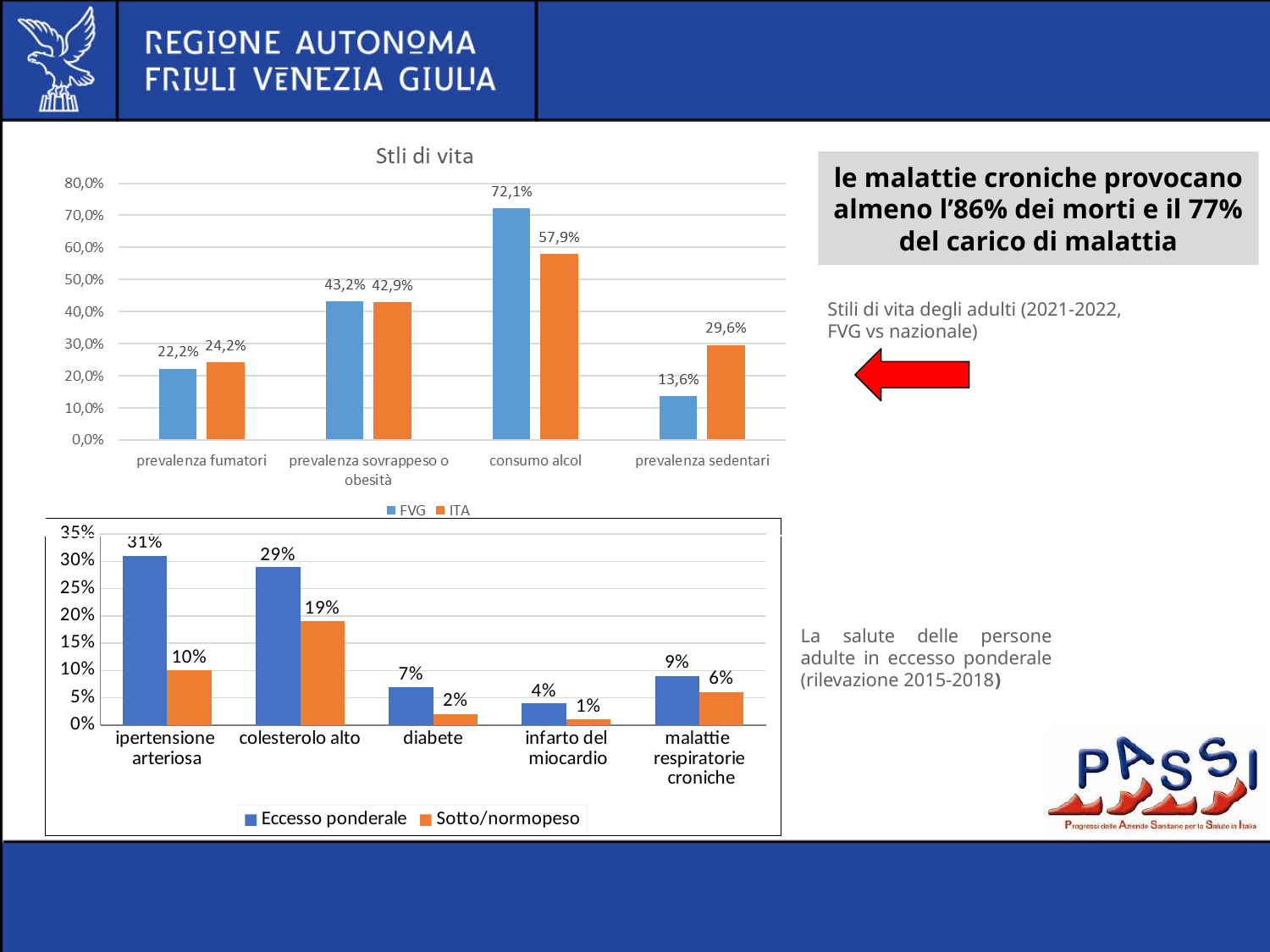
In the bottom chart, what is the difference between the Eccesso ponderale and Sotto/normopeso values for ipertensione arteriosa? 21 percentage points In the bottom chart, what is the Sotto/normopeso value for infarto del miocardio? 1% In the 'Stli di vita' chart, which category has the lowest FVG value? prevalenza sedentari In the 'Stli di vita' chart, what is the FVG value for consumo alcol? 72,1% In the bottom chart, which category has the highest Eccesso ponderale value? ipertensione arteriosa How many series does the legend of the 'Stli di vita' chart list? 2 In the 'Stli di vita' chart, what is the ITA value for prevalenza sedentari? 29,6% In the 'Stli di vita' chart, what is the difference between the FVG and ITA values for consumo alcol? 14,2 percentage points In the 'Stli di vita' chart, which category has the highest FVG value? consumo alcol In the bottom chart, what is the Eccesso ponderale value for colesterolo alto? 29% How many categories are shown on the x axis of the bottom chart? 5 In the 'Stli di vita' chart, is the FVG or the ITA value larger for prevalenza sedentari? ITA